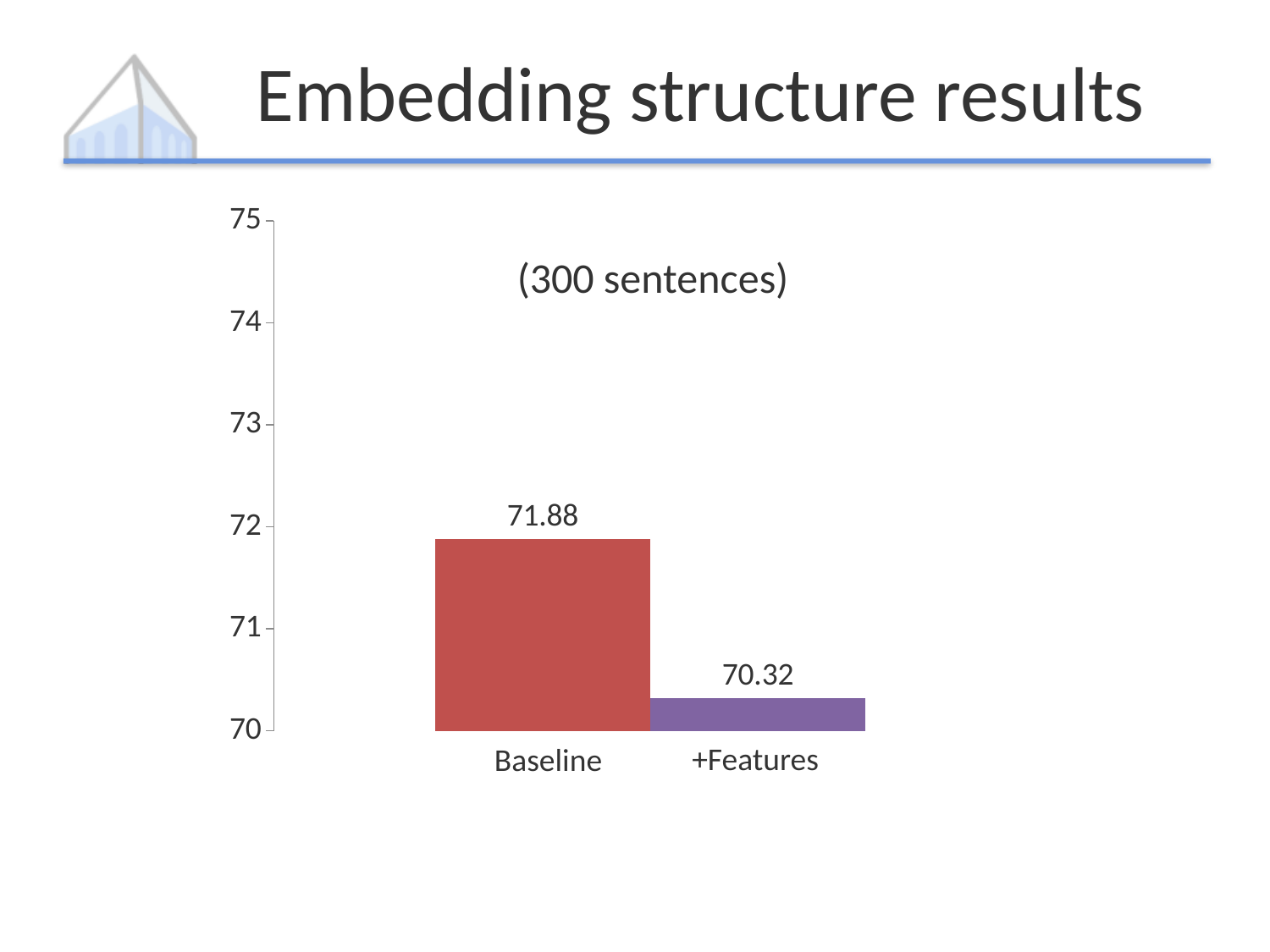
Which is larger, the value for Baseline or the value for +Features? Baseline What is the value for Baseline? 71.88 What text appears inside the chart area above the bars? (300 sentences) Is the value for Baseline greater or less than 71? greater Which category has the lowest value? +Features Is the value for +Features greater or less than 71? less Do the values rise or fall from Baseline to +Features? fall What kind of chart is shown on the slide? bar chart What is the difference between the Baseline and +Features values? 1.56 Which category has the highest value? Baseline What is the value for +Features? 70.32 How many categories are shown on the x axis? 2